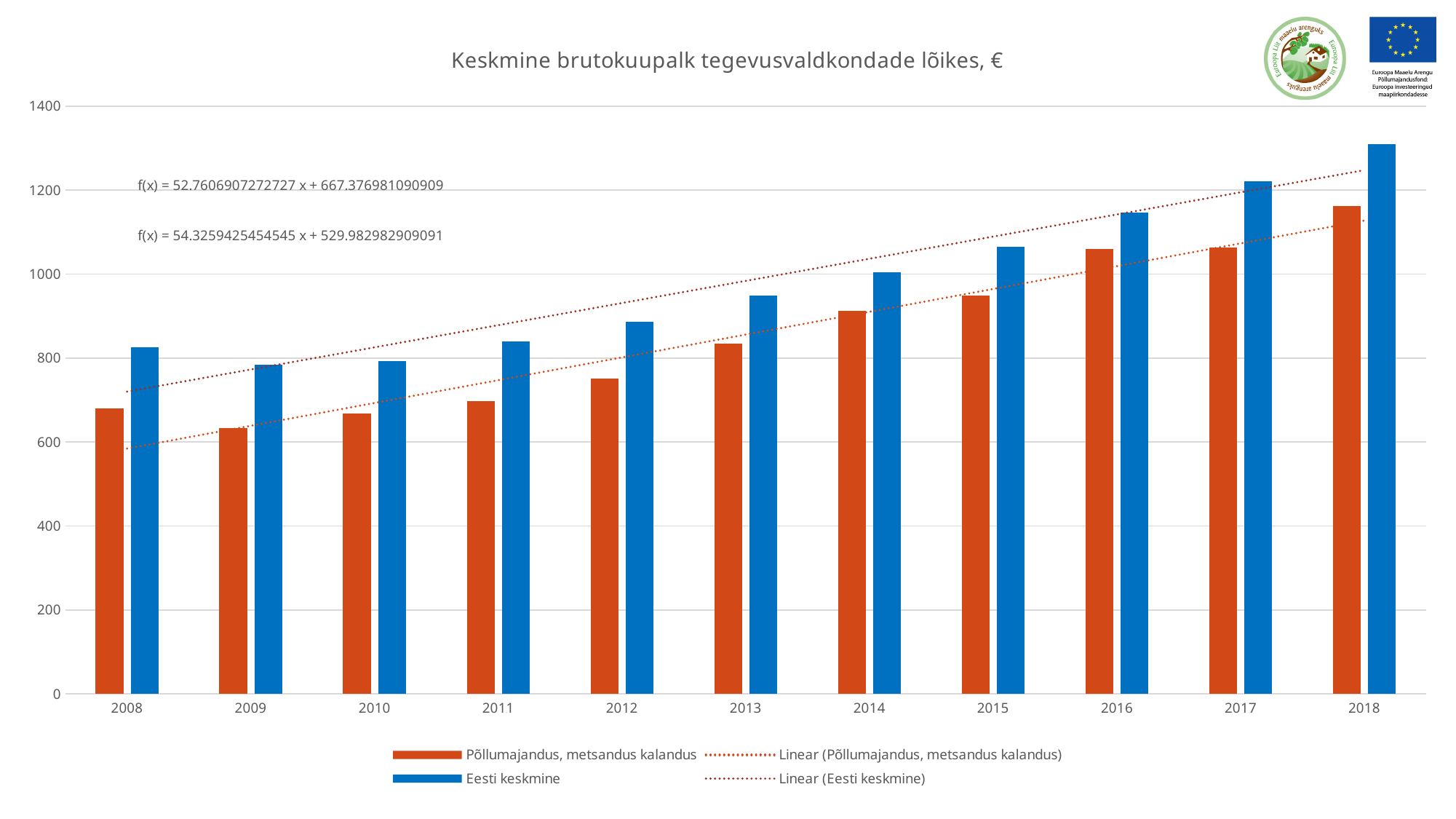
How many entries does the chart's legend list? 4 In which year is the Põllumajandus, metsandus kalandus bar the lowest? 2009 What is the title of the chart? Keskmine brutokuupalk tegevusvaldkondade lõikes, € Is the value for Põllumajandus, metsandus kalandus in 2016 greater or less than 1000? greater Do the Eesti keskmine values generally rise or fall from 2009 to 2018? rise What kind of chart is shown on the slide? bar chart Is the value for Eesti keskmine in 2018 greater or less than 1200? greater Is the value for Põllumajandus, metsandus kalandus in 2009 greater or less than 800? less How many years are shown on the x axis of the chart? 11 In 2018, which is larger: Eesti keskmine or Põllumajandus, metsandus kalandus? Eesti keskmine In which year is the Eesti keskmine bar the highest? 2018